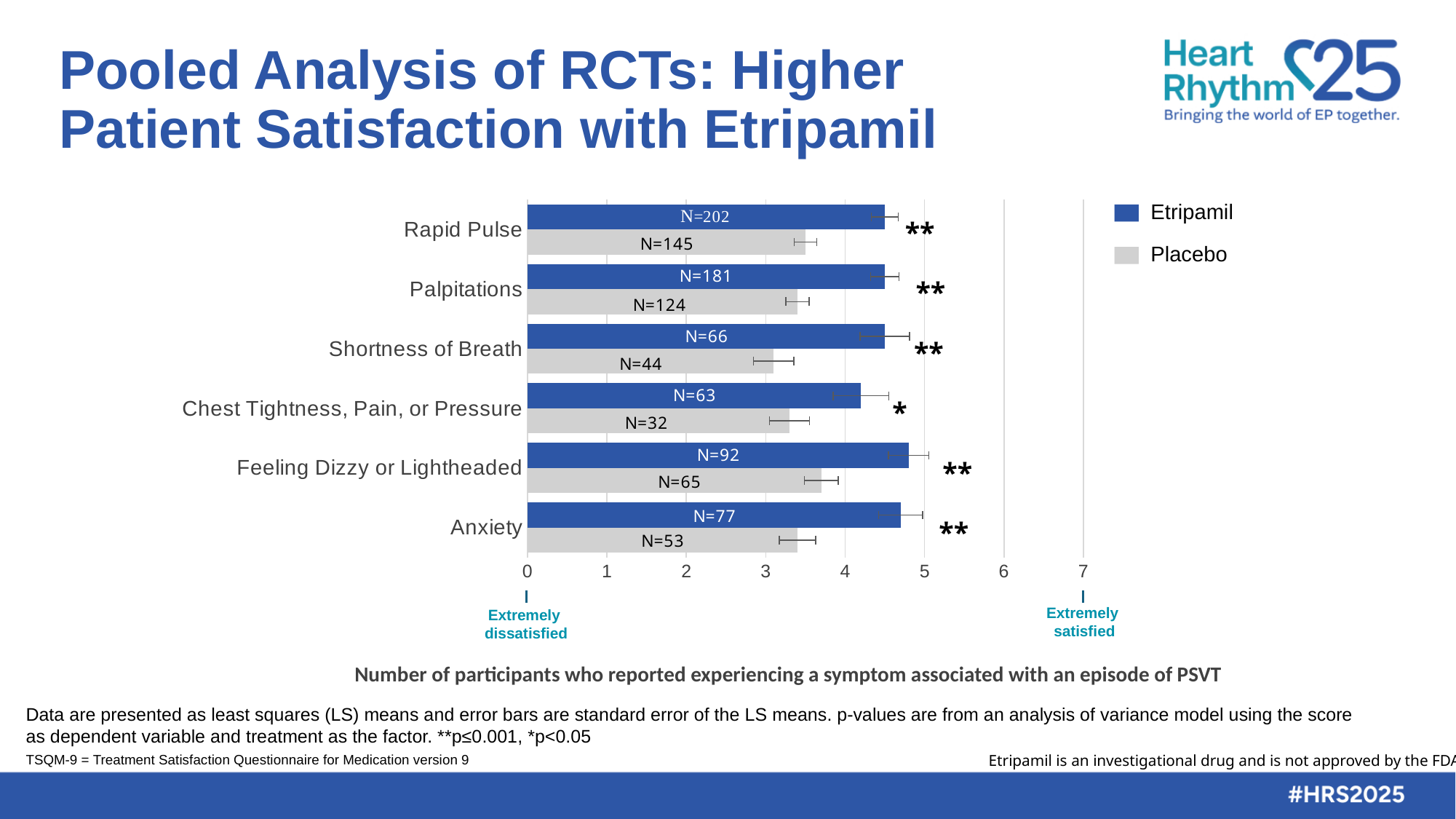
Which symptom category has the lowest Etripamil satisfaction score? Chest Tightness, Pain, or Pressure How many symptom categories are plotted on the chart? 6 What is the N label on the Placebo bar for Anxiety? N=53 Is the Placebo satisfaction score for Shortness of Breath greater or less than 4? less Is the Etripamil satisfaction score for Rapid Pulse greater or less than 4? greater What is the N label on the Etripamil bar for Rapid Pulse? N=202 For Chest Tightness, Pain, or Pressure, which series has the higher satisfaction score, Etripamil or Placebo? Etripamil What is the N label on the Placebo bar for Palpitations? N=124 How many series does the legend list? 2 How many more participants are in the Etripamil group than the Placebo group for Rapid Pulse, based on the N labels? 57 What kind of chart is shown on the slide? bar chart What is the N label on the Etripamil bar for Feeling Dizzy or Lightheaded? N=92